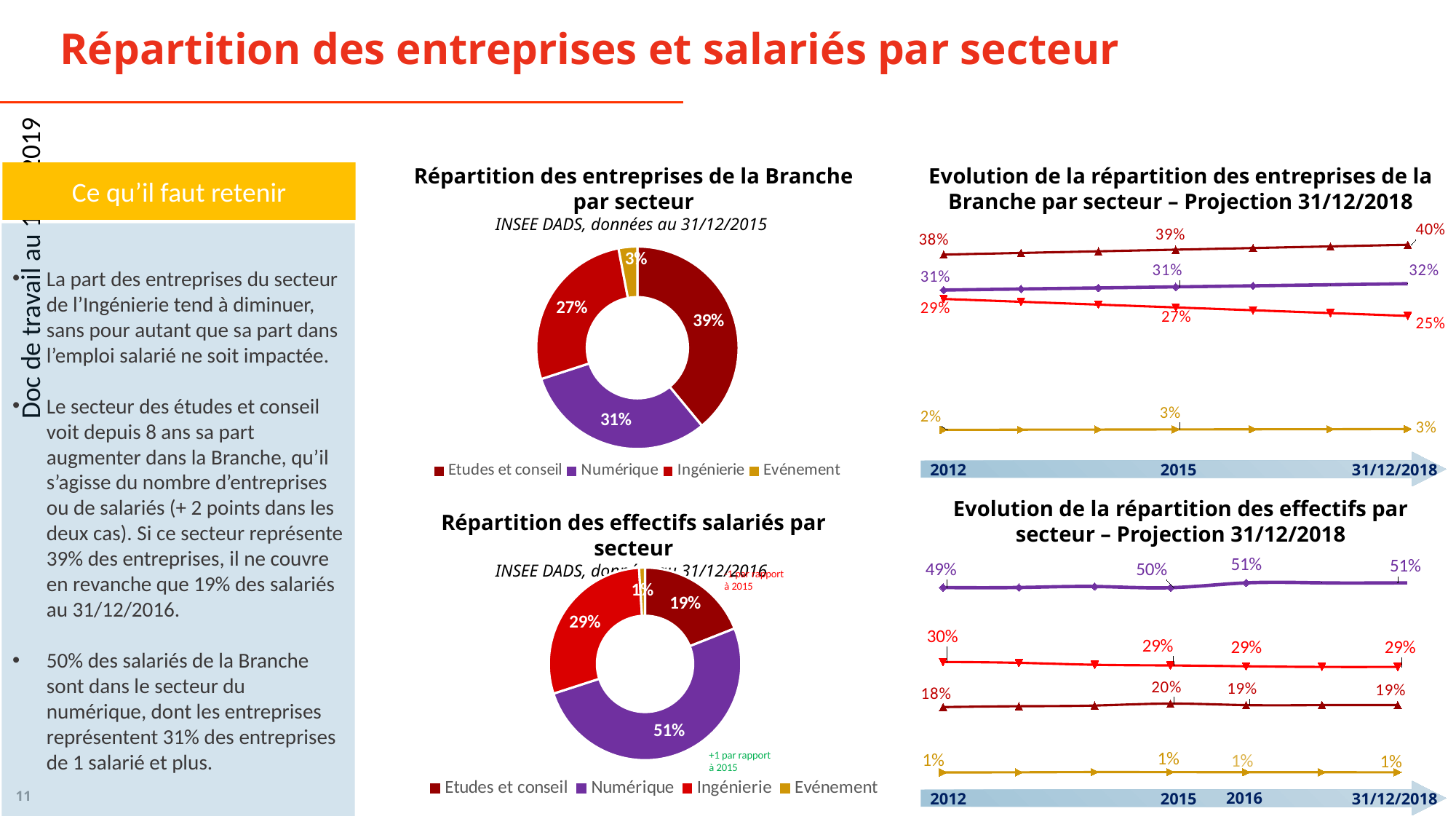
In the chart 'Evolution de la répartition des entreprises de la Branche par secteur – Projection 31/12/2018', does the line that starts at 29% in 2012 rise or fall over time? Fall In the chart 'Répartition des effectifs salariés par secteur', what share is shown for Ingénierie? 29% In the chart 'Répartition des entreprises de la Branche par secteur', what is the difference between the shares of Etudes et conseil and Ingénierie? 12 percentage points In the chart 'Répartition des entreprises de la Branche par secteur', which sector has the largest share? Etudes et conseil How many sectors does the legend of the chart 'Répartition des effectifs salariés par secteur' list? 4 In the chart 'Evolution de la répartition des effectifs par secteur – Projection 31/12/2018', what value does the top (purple) line show for 2012? 49% How many time points are shown on the x axis of the chart 'Evolution de la répartition des effectifs par secteur – Projection 31/12/2018'? 4 In the chart 'Répartition des entreprises de la Branche par secteur', which sector has the smallest share? Evénement In the chart 'Répartition des entreprises de la Branche par secteur', what share is shown for Numérique? 31% In the chart 'Répartition des effectifs salariés par secteur', which sector has the largest share? Numérique In the chart 'Evolution de la répartition des entreprises de la Branche par secteur – Projection 31/12/2018', what value does the top line show for 31/12/2018? 40% What kind of chart is 'Répartition des effectifs salariés par secteur'? Pie (donut) chart